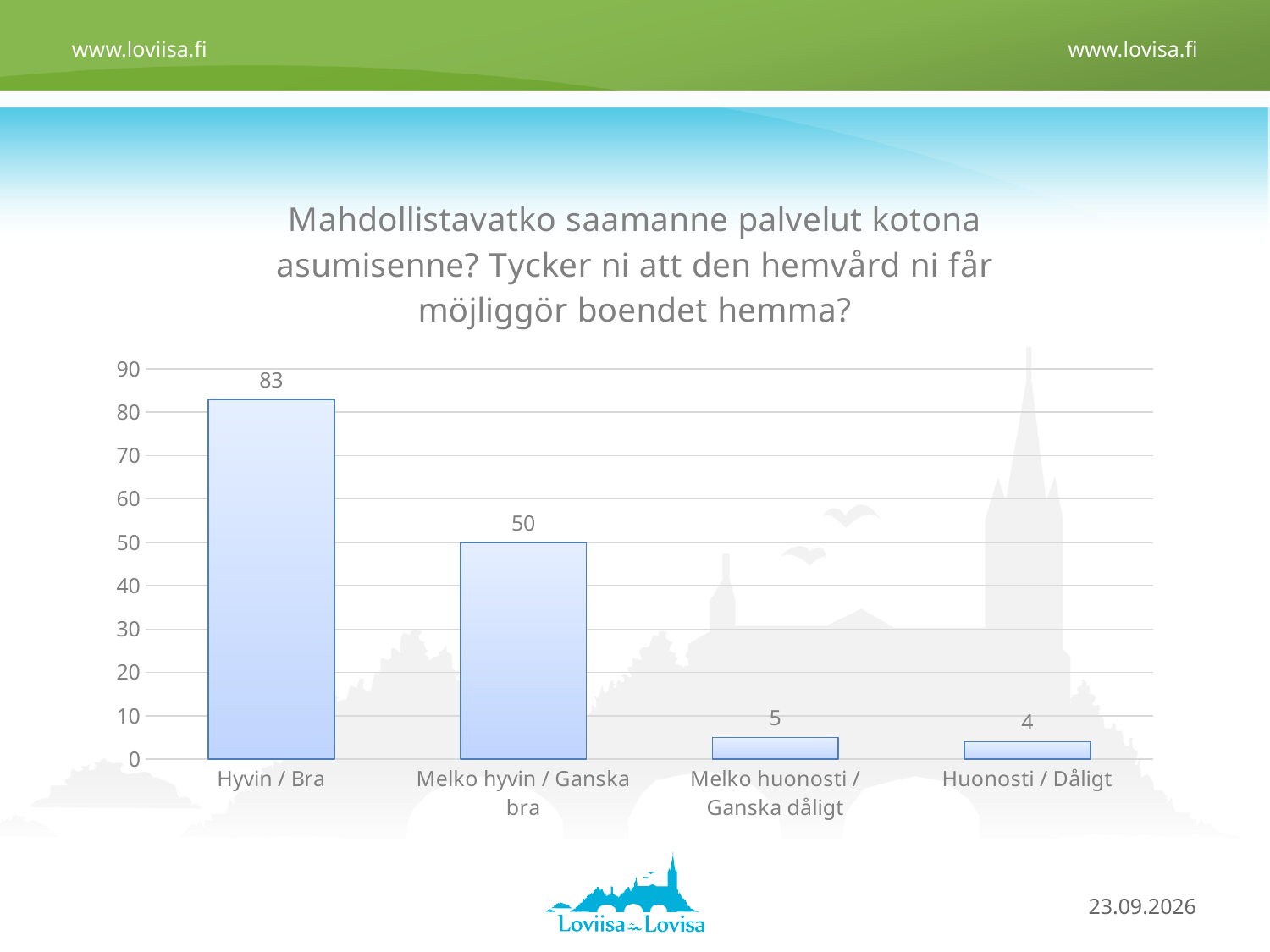
What is the difference between the values for Hyvin / Bra and Melko hyvin / Ganska bra? 33 What is the value for Hyvin / Bra? 83 How many categories are shown on the x axis? 4 Which category has the lowest value? Huonosti / Dåligt What is the value for Melko hyvin / Ganska bra? 50 Do the values rise or fall from left to right along the x axis? fall Which category has the highest value? Hyvin / Bra Is the value for Hyvin / Bra greater or less than 80? greater Which is larger, the value for Melko hyvin / Ganska bra or the value for Melko huonosti / Ganska dåligt? Melko hyvin / Ganska bra What is the value for Huonosti / Dåligt? 4 What kind of chart is shown on the slide? bar chart What is the value for Melko huonosti / Ganska dåligt? 5